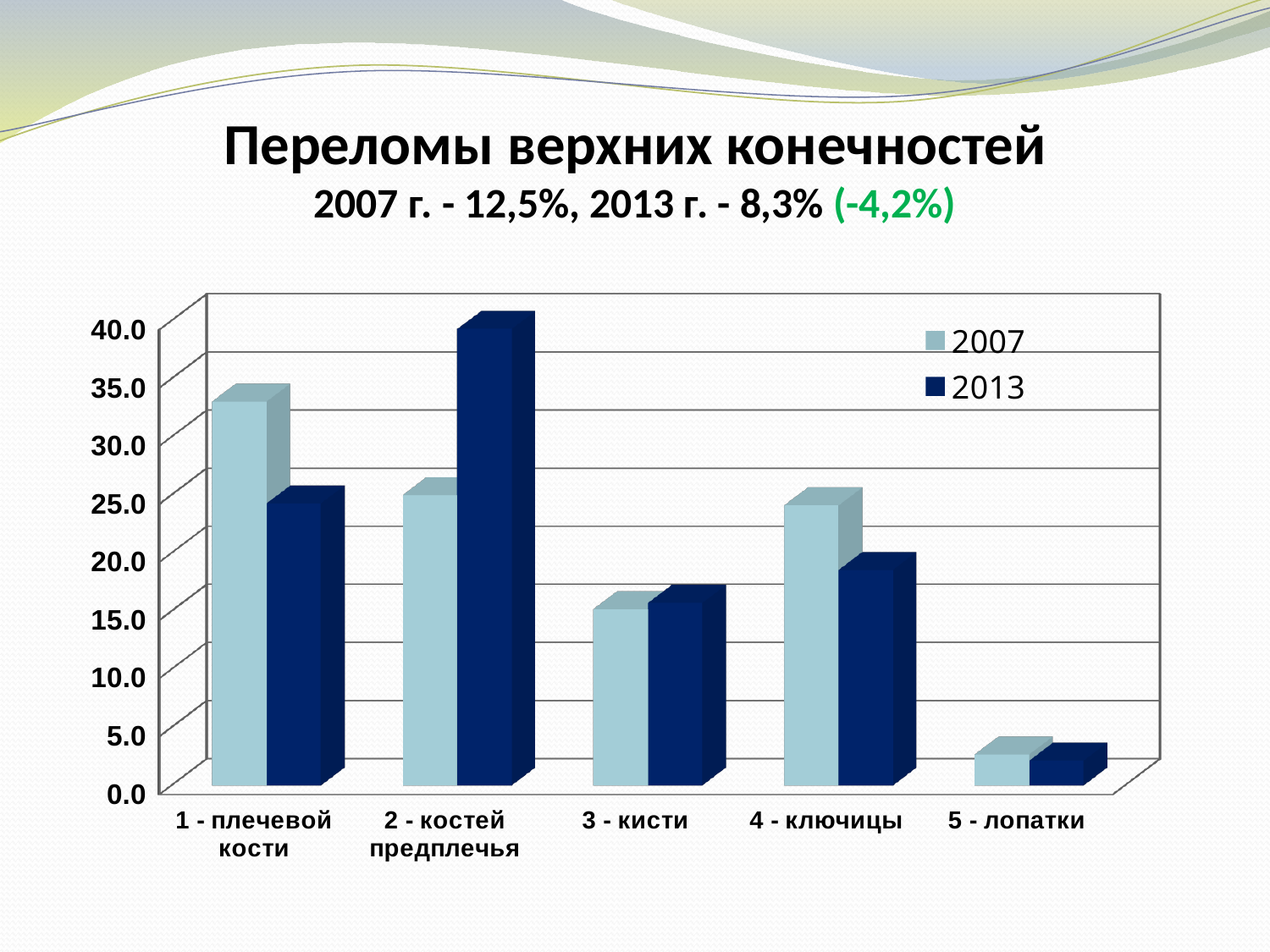
For 2 - костей предплечья, which series has the larger value, 2007 or 2013? 2013 Which category has the lowest value for 2007? 5 - лопатки Is the 2013 value for 2 - костей предплечья greater or less than 35.0? greater Which category has the highest value for 2007? 1 - плечевой кости For 1 - плечевой кости, which series has the larger value, 2007 or 2013? 2007 How many series does the legend list? 2 How many categories are shown on the x axis? 5 What are the two entries in the chart legend? 2007 and 2013 Which category has the highest value for 2013? 2 - костей предплечья Which category has the lowest value for 2013? 5 - лопатки What kind of chart is shown on the slide? bar chart Is the 2007 value for 5 - лопатки greater or less than 5.0? less